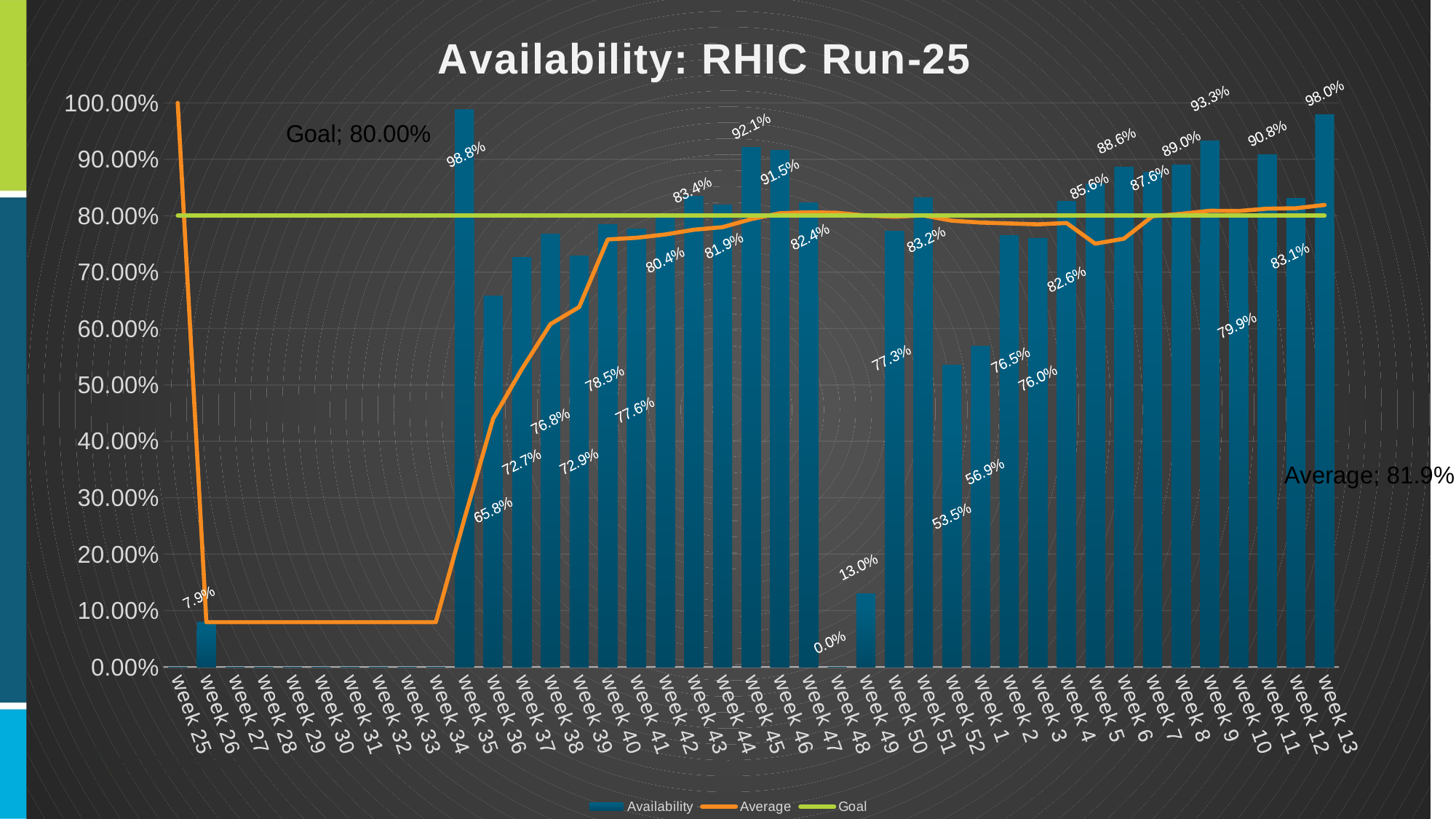
What kind of chart is shown on the slide? combination bar and line chart What is the difference between the availability for week 44 and week 45? 10.2% What is the availability for week 44? 81.9% How many series does the legend list? 3 What is the Goal value shown on the chart? 80.00% Which has the higher availability, week 51 or week 52? week 51 What is the availability for week 48? 0.0% Is the availability for week 35 greater or less than 70.00%? greater What is the Average value shown on the chart? 81.9% What is the availability for week 34? 0.0% What is the availability for week 8? 89.0% Does the availability rise or fall from week 3 to week 5? rise